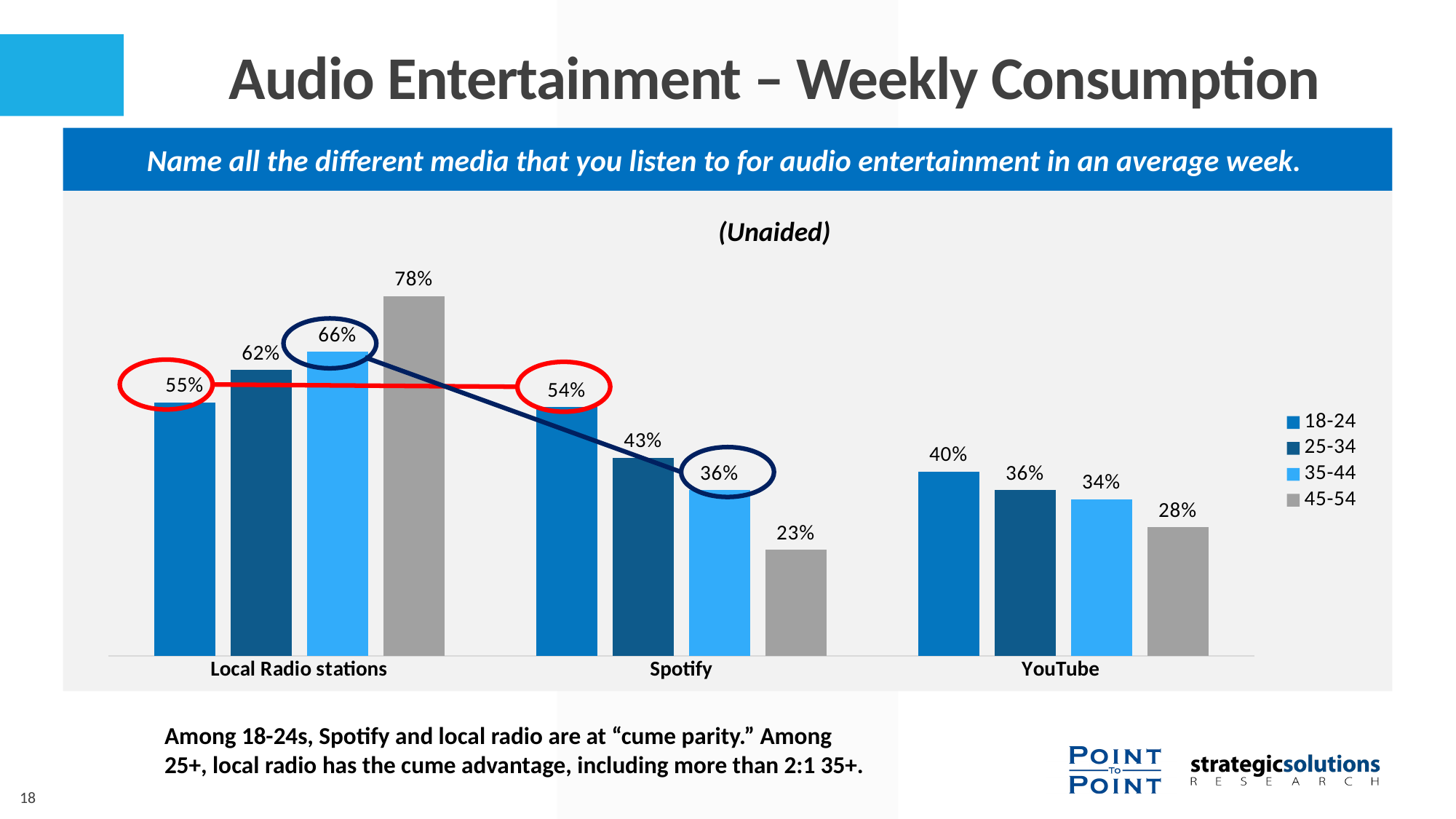
What percentage of 18-24s listen to Spotify in an average week? 54% What is the difference between the 45-54 and 18-24 values for Local Radio stations? 23 percentage points What is the value for the 45-54 group for Local Radio stations? 78% Which is larger for the 25-34 group: Spotify or YouTube? Spotify Which age group has the highest value for Local Radio stations? 45-54 What is the value for the 35-44 group for YouTube? 34% What kind of chart is shown on the slide? Bar chart Do the values for Spotify rise or fall as the age group gets older? Fall What is the difference between the 18-24 values for Spotify and YouTube? 14 percentage points Which age group has the lowest value for Spotify? 45-54 How many age groups does the legend list? 4 How many media categories are shown on the x axis? 3